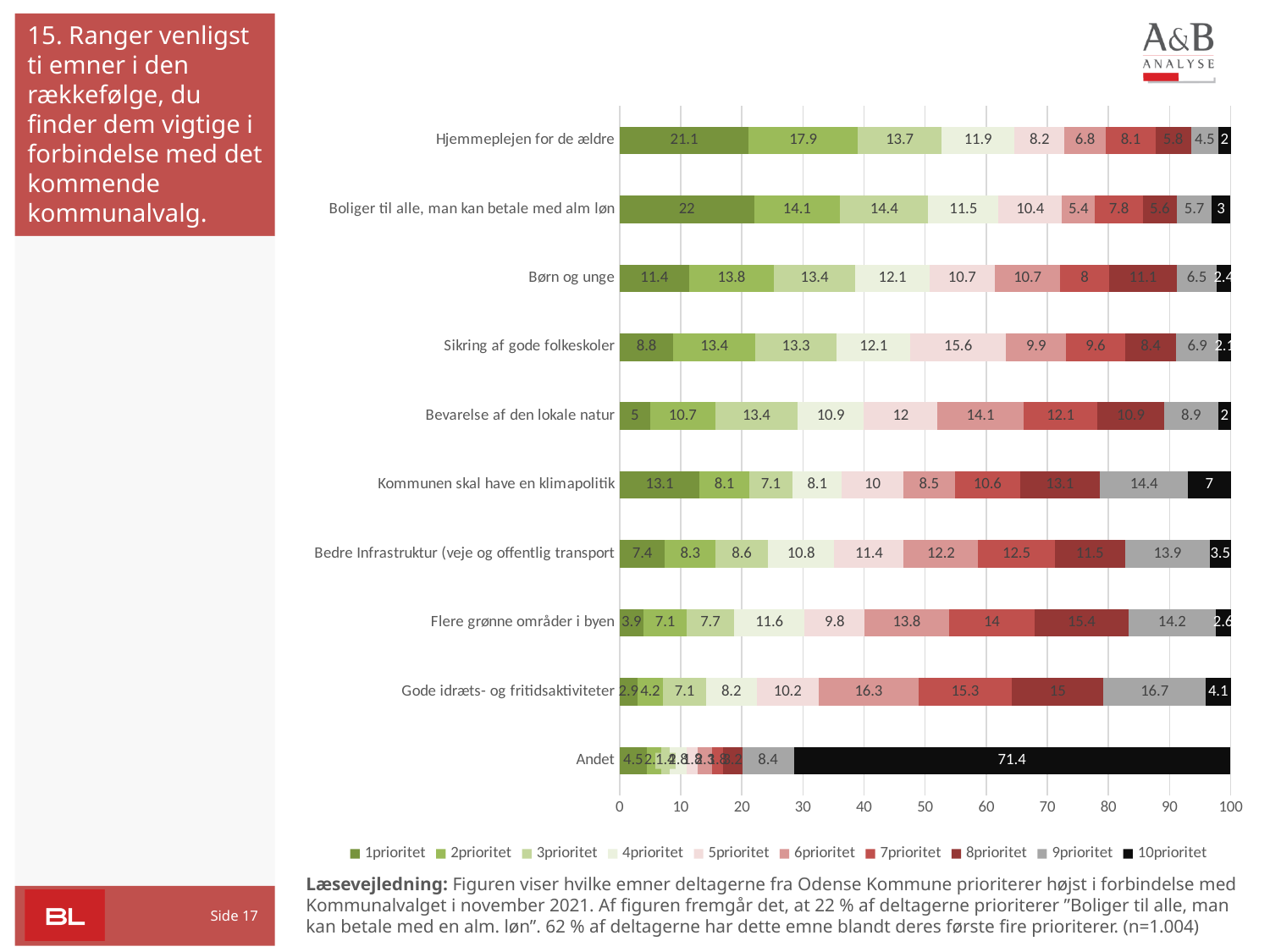
Which category has the lowest 1prioritet value? Gode idræts- og fritidsaktiviteter How many categories are shown on the chart? 10 Which category has the highest 1prioritet value? Boliger til alle, man kan betale med alm løn How many series does the legend list? 10 Which has the larger 9prioritet value: "Gode idræts- og fritidsaktiviteter" or "Flere grønne områder i byen"? Gode idræts- og fritidsaktiviteter What is the value of 1prioritet for "Boliger til alle, man kan betale med alm løn"? 22 What is the value of 9prioritet for "Gode idræts- og fritidsaktiviteter"? 16.7 What is the value of 10prioritet for "Andet"? 71.4 What is the difference between the 1prioritet values for "Boliger til alle, man kan betale med alm løn" and "Hjemmeplejen for de ældre"? 0.9 What kind of chart is shown on the slide? Stacked bar chart What is the value of 5prioritet for "Sikring af gode folkeskoler"? 15.6 What is the value of 1prioritet for "Hjemmeplejen for de ældre"? 21.1